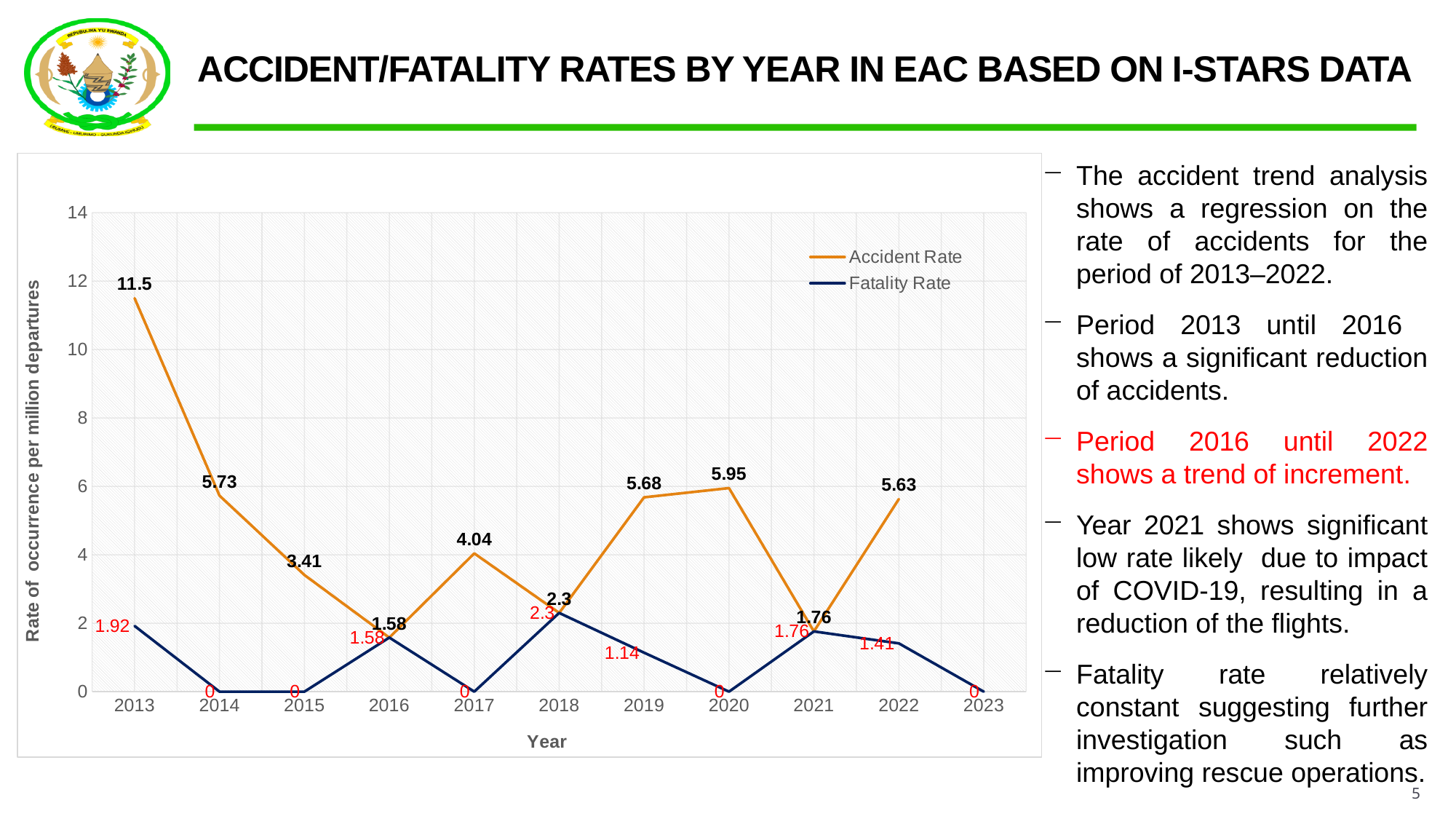
In which year is the Accident Rate lowest? 2016 How many years are shown on the x axis? 11 What is the label of the y axis? Rate of occurrence per million departures What type of chart is shown on the slide? line chart How many series does the legend list? 2 What is the Fatality Rate for 2019? 1.14 What is the Accident Rate for 2020? 5.95 Does the Accident Rate rise or fall from 2013 to 2016? fall Which is larger, the Accident Rate in 2019 or in 2022? 2019 In which year is the Accident Rate highest? 2013 What is the difference between the Accident Rate in 2013 and in 2014? 5.77 What is the Accident Rate for 2013? 11.5